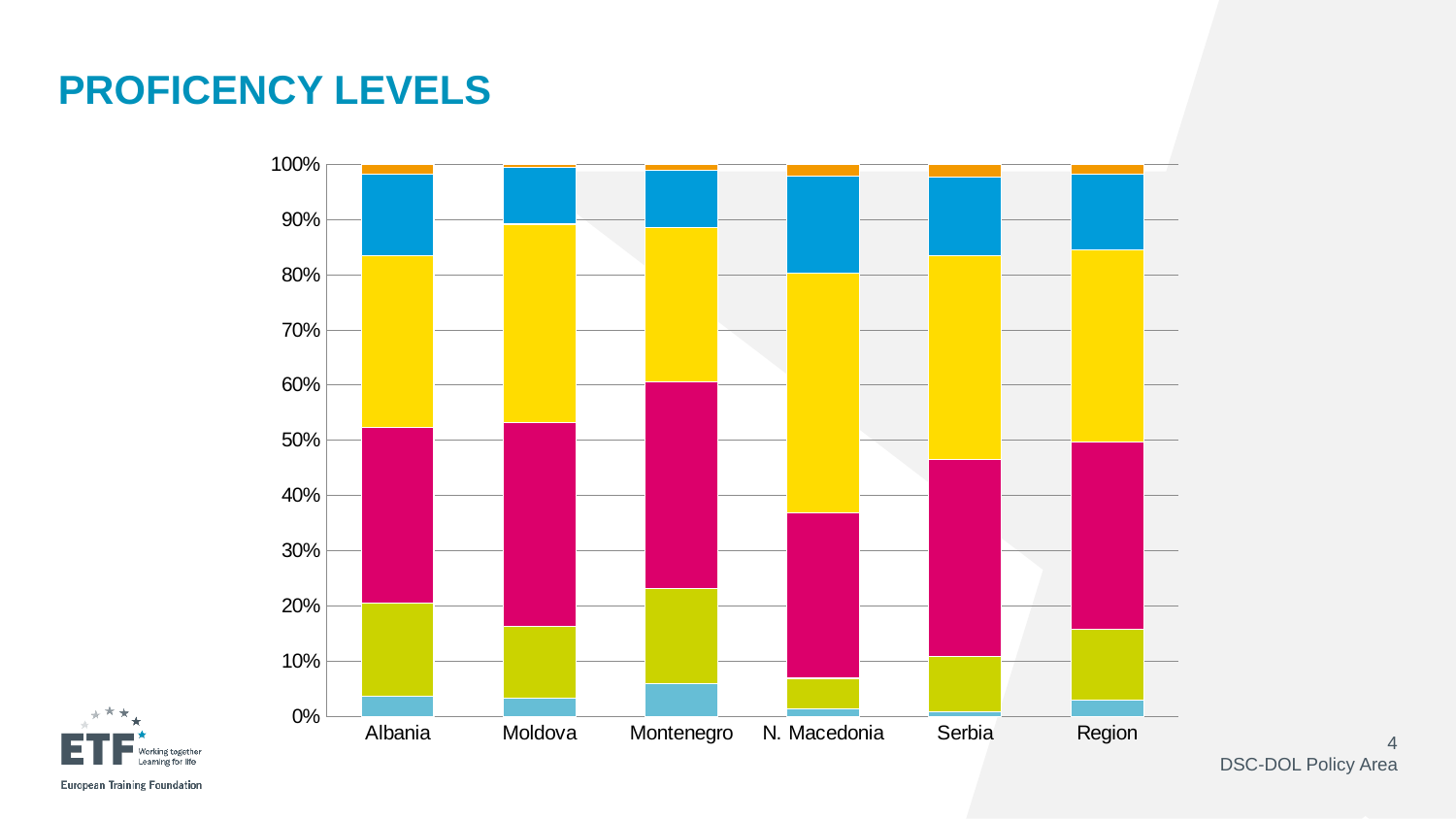
Which category has the smallest green segment? N. Macedonia What is the total height of each stacked bar in the chart? 100% Is the top of the yellow segment for Albania greater or less than 80%? greater Is the top of the green segment for N. Macedonia greater or less than 10%? less Which category has the largest yellow segment? N. Macedonia Which category has the largest light blue segment at the bottom of its bar? Montenegro How many categories are shown on the x axis of the chart? 6 Is the top of the green segment for Montenegro greater or less than 20%? greater What kind of chart is shown on the slide? Stacked bar chart What is the title of the slide containing the chart? PROFICENCY LEVELS